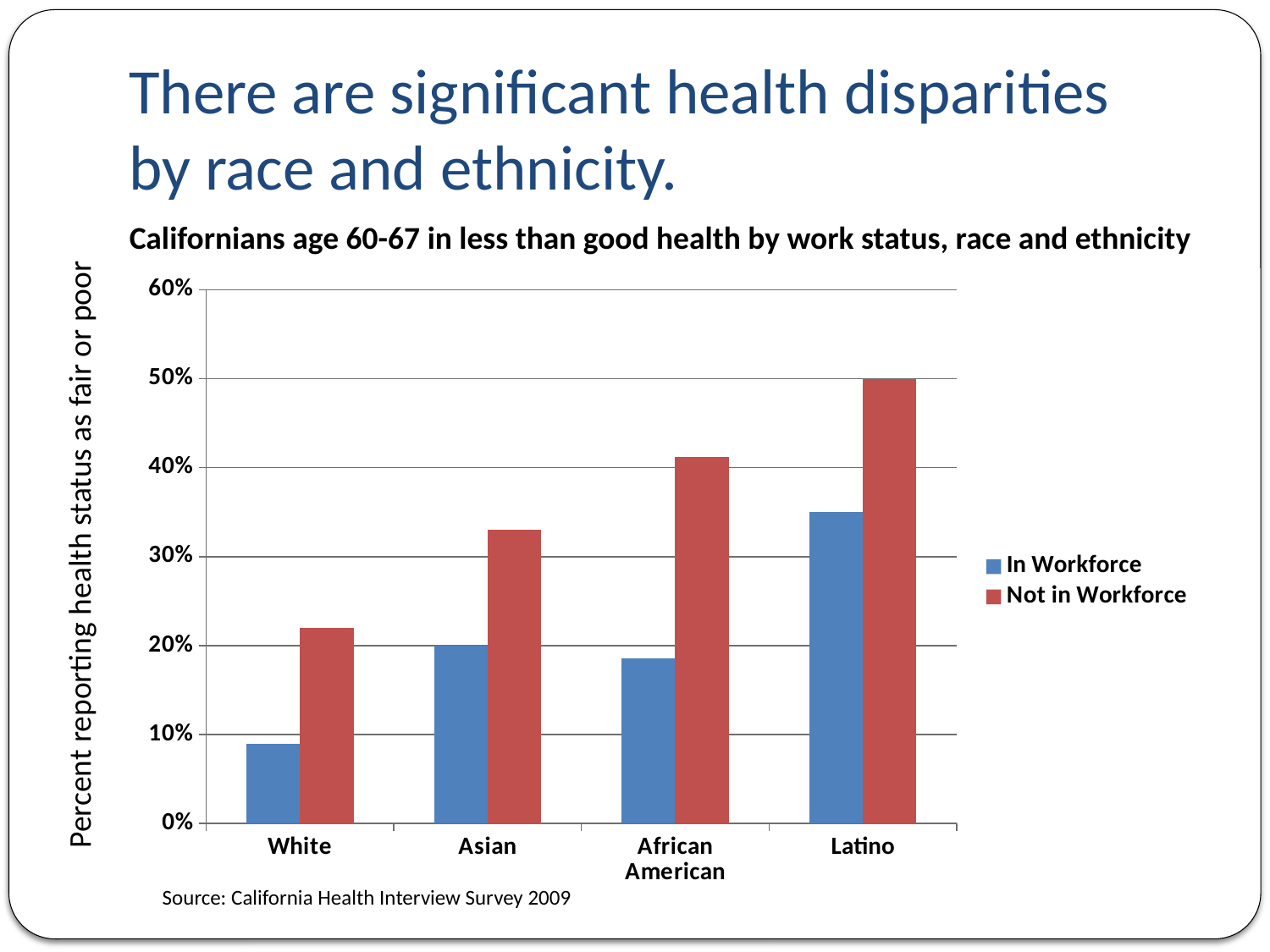
How many race/ethnicity categories are shown on the x axis? 4 Is the In Workforce value for Latino greater or less than 30%? greater Is the Not in Workforce value for African American greater or less than 40%? greater Which category has the highest Not in Workforce value? Latino Is the In Workforce value for White greater or less than 10%? less What is the title of the chart? Californians age 60-67 in less than good health by work status, race and ethnicity Do the Not in Workforce values rise or fall from White to Latino along the x axis? rise What kind of chart is shown on the slide? bar chart Which category has the lowest In Workforce value? White How many series does the legend list? 2 For Asian, which is larger: In Workforce or Not in Workforce? Not in Workforce